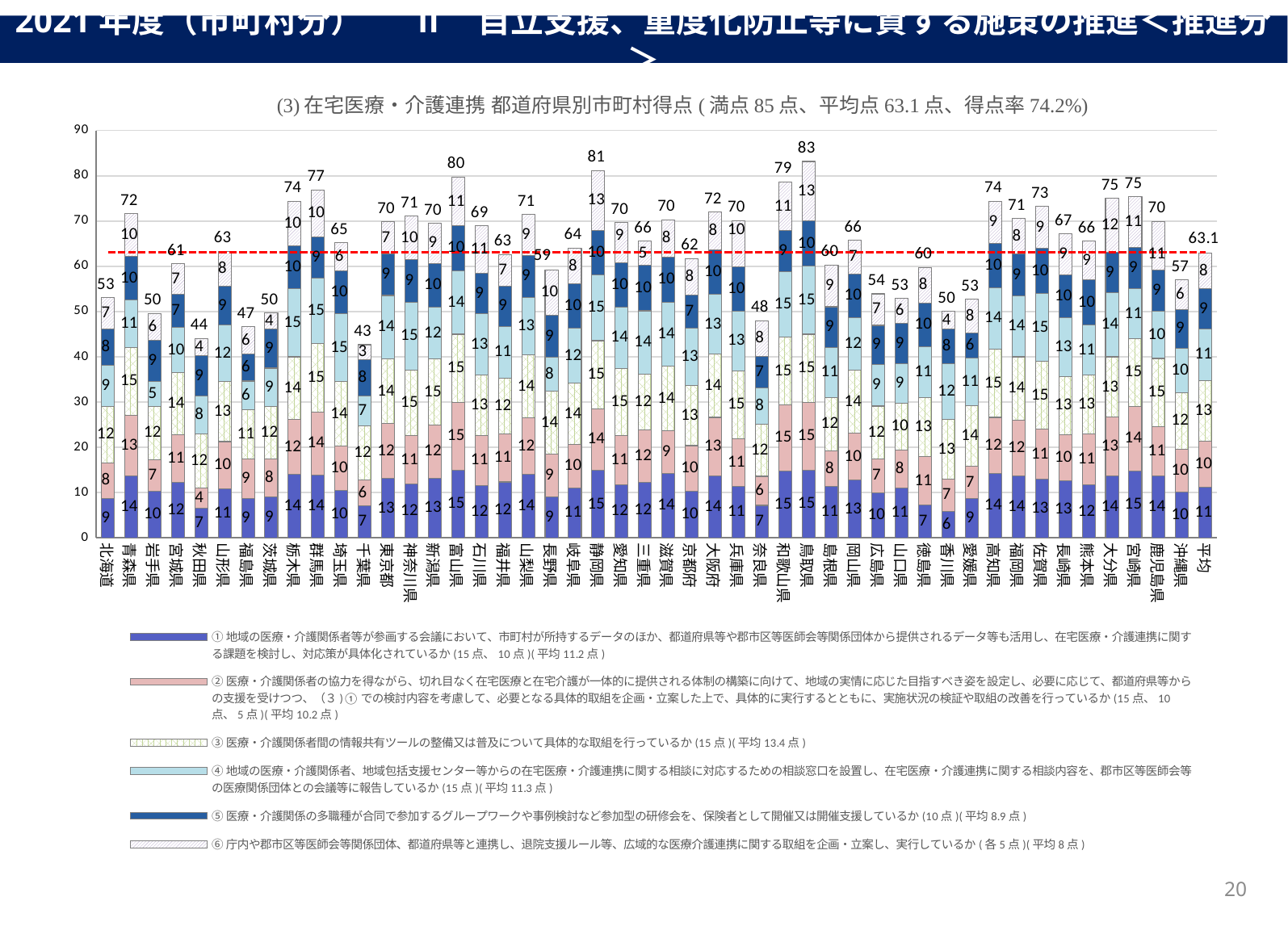
Which prefecture has the lowest total score in the chart? 千葉県 What is the total score shown for 富山県? 80 What is the difference between the total score of 鳥取県 and that of 千葉県? 40 What is the value of the bottom (series ①) segment of the 青森県 bar? 14 What kind of chart is shown on the slide? Stacked bar chart What is the 満点 (maximum score) stated in the chart title? 85 点 Is the total score for 秋田県 greater or less than 50? less How many series does the legend list? 6 What is the total score shown for 静岡県? 81 Which prefecture has the highest total score in the chart? 鳥取県 What is the value shown for the 平均 bar at the far right of the chart? 63.1 Which has a higher total score, 群馬県 or 栃木県? 群馬県